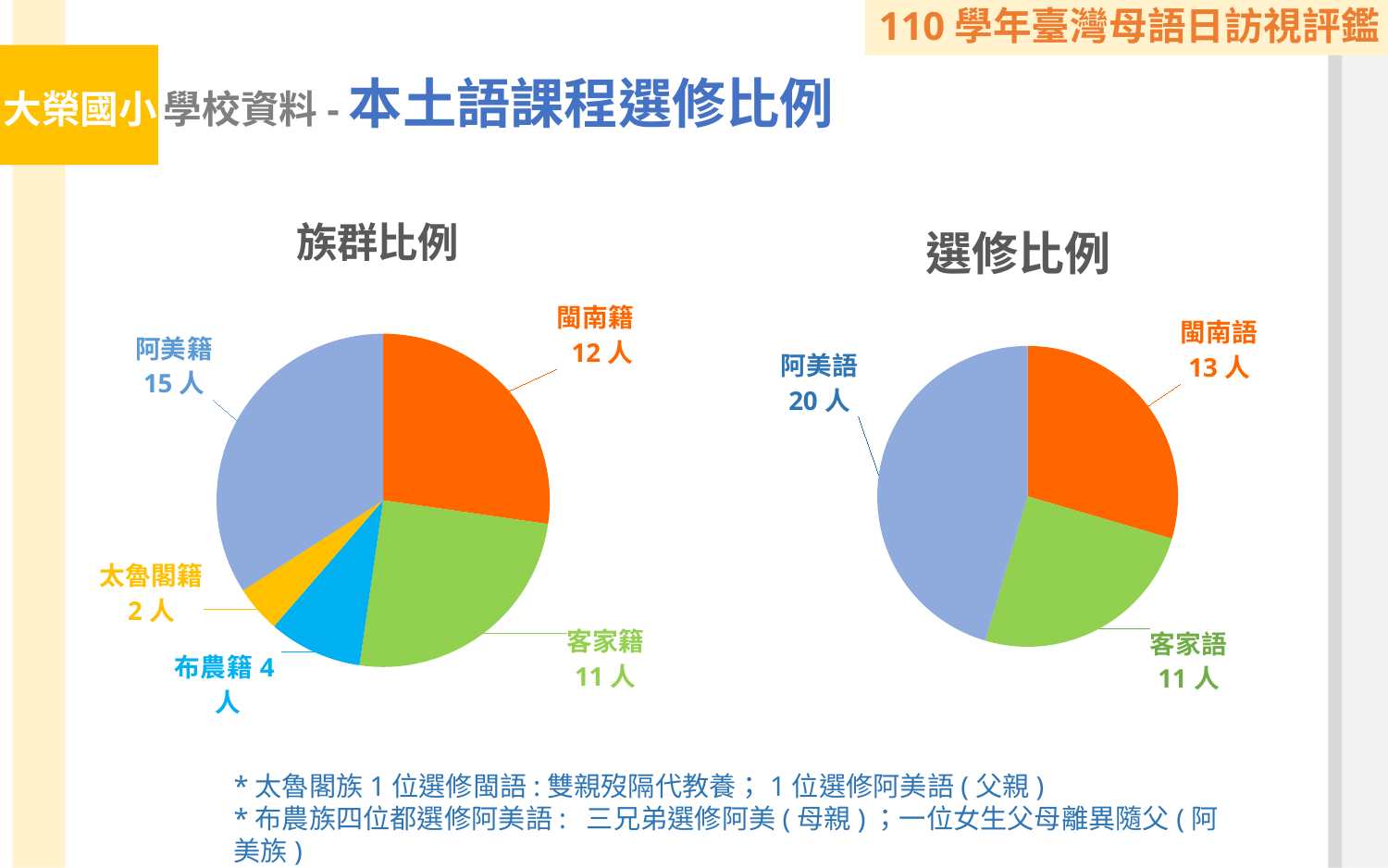
What kind of chart is the 選修比例 chart? Pie chart In the 族群比例 pie chart, what is the difference between 閩南籍 and 布農籍? 8 人 How many slices does the 族群比例 pie chart have? 5 In the 族群比例 pie chart, which is larger, 閩南籍 or 客家籍? 閩南籍 In the 族群比例 pie chart, which group has the smallest slice? 太魯閣籍 In the 選修比例 pie chart, how many people chose 客家語? 11 人 In the 選修比例 pie chart, how many people chose 阿美語? 20 人 In the 族群比例 pie chart, how many people are 阿美籍? 15 人 In the 選修比例 pie chart, what is the difference between the number choosing 阿美語 and the number choosing 閩南語? 7 人 In the 族群比例 pie chart, which group has the largest slice? 阿美籍 In the 選修比例 pie chart, which language has the smallest slice? 客家語 In the 族群比例 pie chart, how many people are 太魯閣籍? 2 人